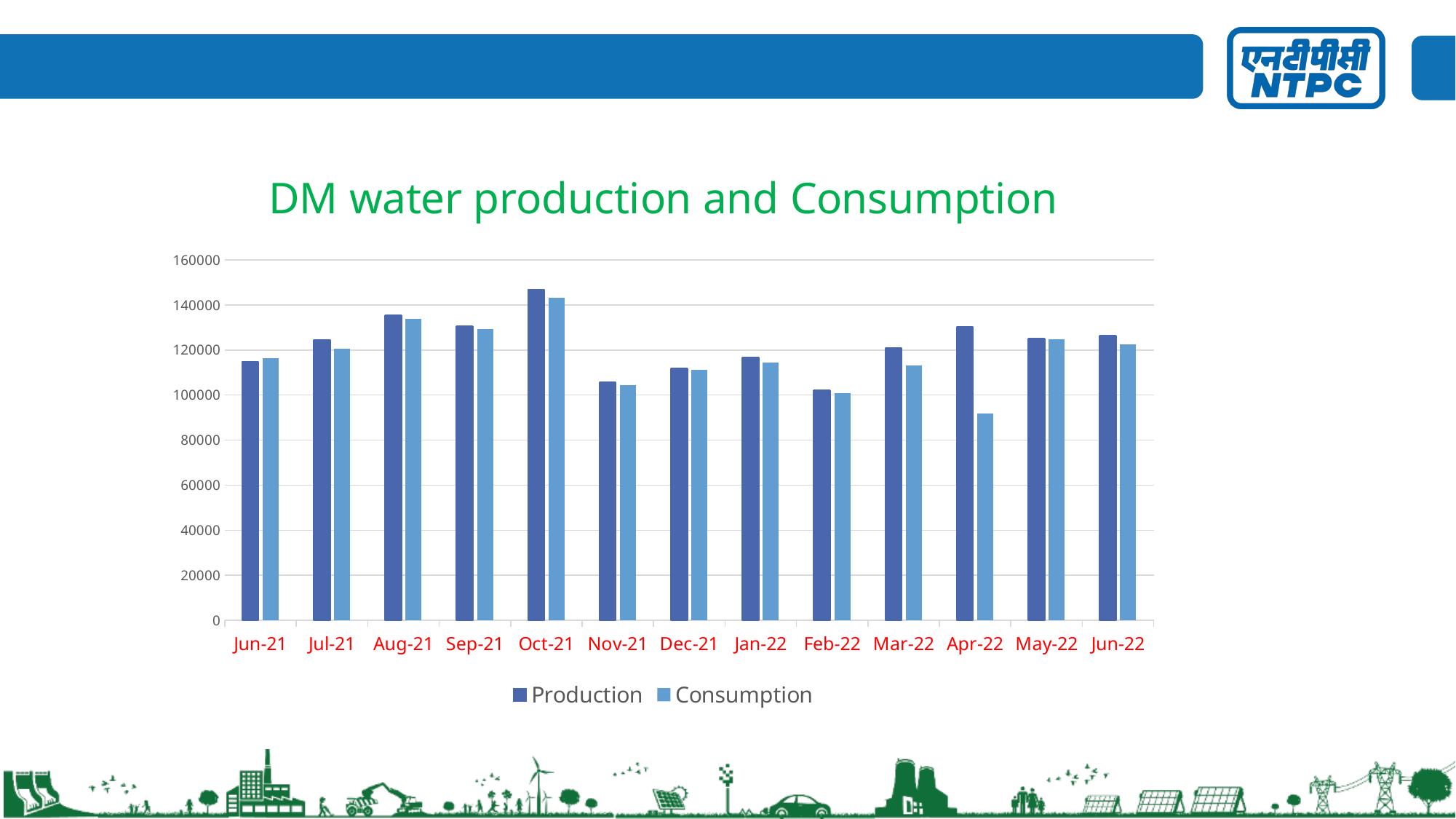
How many series does the legend list? 2 Which month has the highest Production value? Oct-21 Which is larger, the Production value for Oct-21 or for Nov-21? Oct-21 What type of chart is shown on the slide? bar chart How many months are shown on the x axis? 13 Is the Production value for Oct-21 greater or less than 140000? greater Is the Consumption value for Apr-22 greater or less than 100000? less Which month has the lowest Consumption value? Apr-22 Is the Consumption value for Aug-21 greater or less than 120000? greater In Apr-22, which is larger, Production or Consumption? Production What is the title of the chart? DM water production and Consumption Which month has the lowest Production value? Feb-22